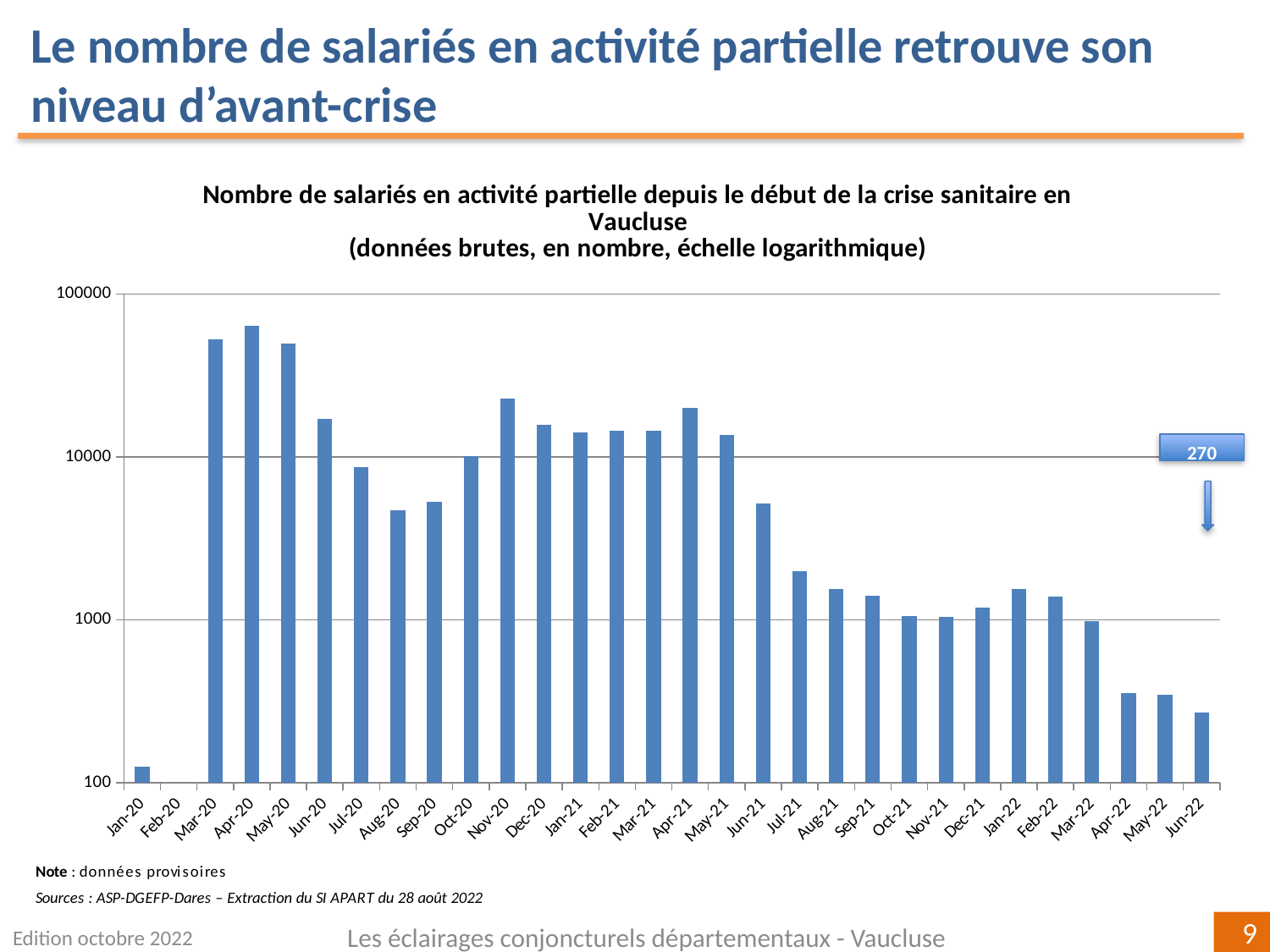
What is the number of employees in partial activity in Vaucluse for Jun-22, as shown by the data label? 270 Is the value for Aug-20 greater or less than 10000? less Do the values generally rise or fall from Apr-21 to Jun-22? Fall What kind of scale does the chart's vertical axis use, according to the chart title? Logarithmic scale (échelle logarithmique) Is the value for Apr-20 greater or less than 10000? greater What type of chart is shown on the slide? Bar chart Which is larger, the value for Nov-20 or the value for Dec-20? Nov-20 How many months are shown on the x axis of the chart? 30 Is the value for Apr-22 greater or less than 1000? less Which is larger, the value for Jan-20 or the value for Jun-22? Jun-22 Which month has the highest bar in the chart? Apr-20